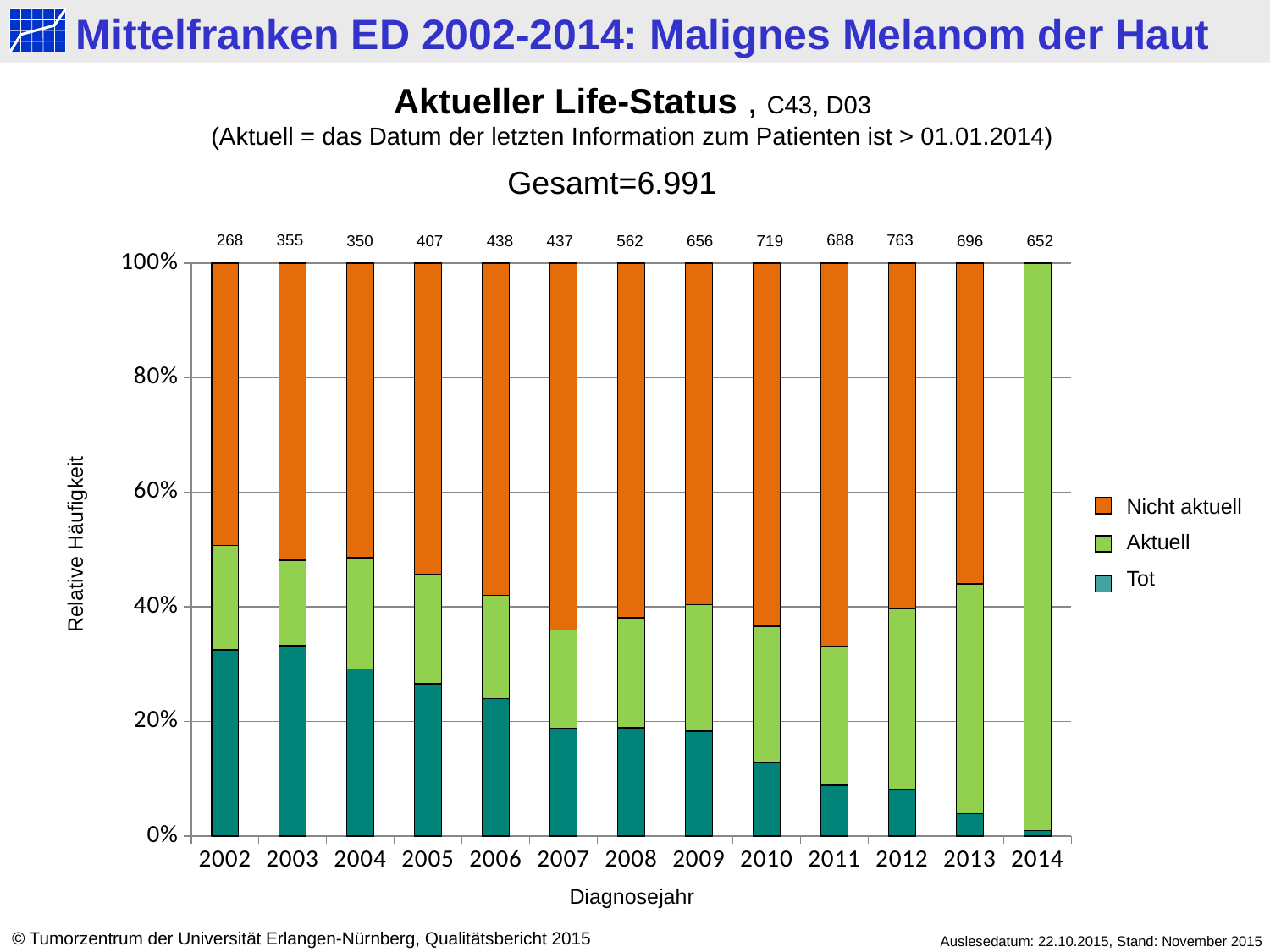
How many diagnosis years are shown on the x axis? 13 What is the difference between the numbers printed above the bars for 2012 and 2002? 495 Which diagnosis year has the lowest number printed above its bar? 2002 What is the number printed above the bar for 2002? 268 How many series does the legend list? 3 What is the number printed above the bar for 2014? 652 What is the number printed above the bar for 2012? 763 Which diagnosis year has the highest number printed above its bar? 2012 Which year has the larger number printed above its bar, 2010 or 2011? 2010 Is the 'Tot' share for 2013 greater or less than 20%? less What kind of chart is shown on the slide? Stacked bar chart Is the 'Tot' share for 2002 greater or less than 20%? greater